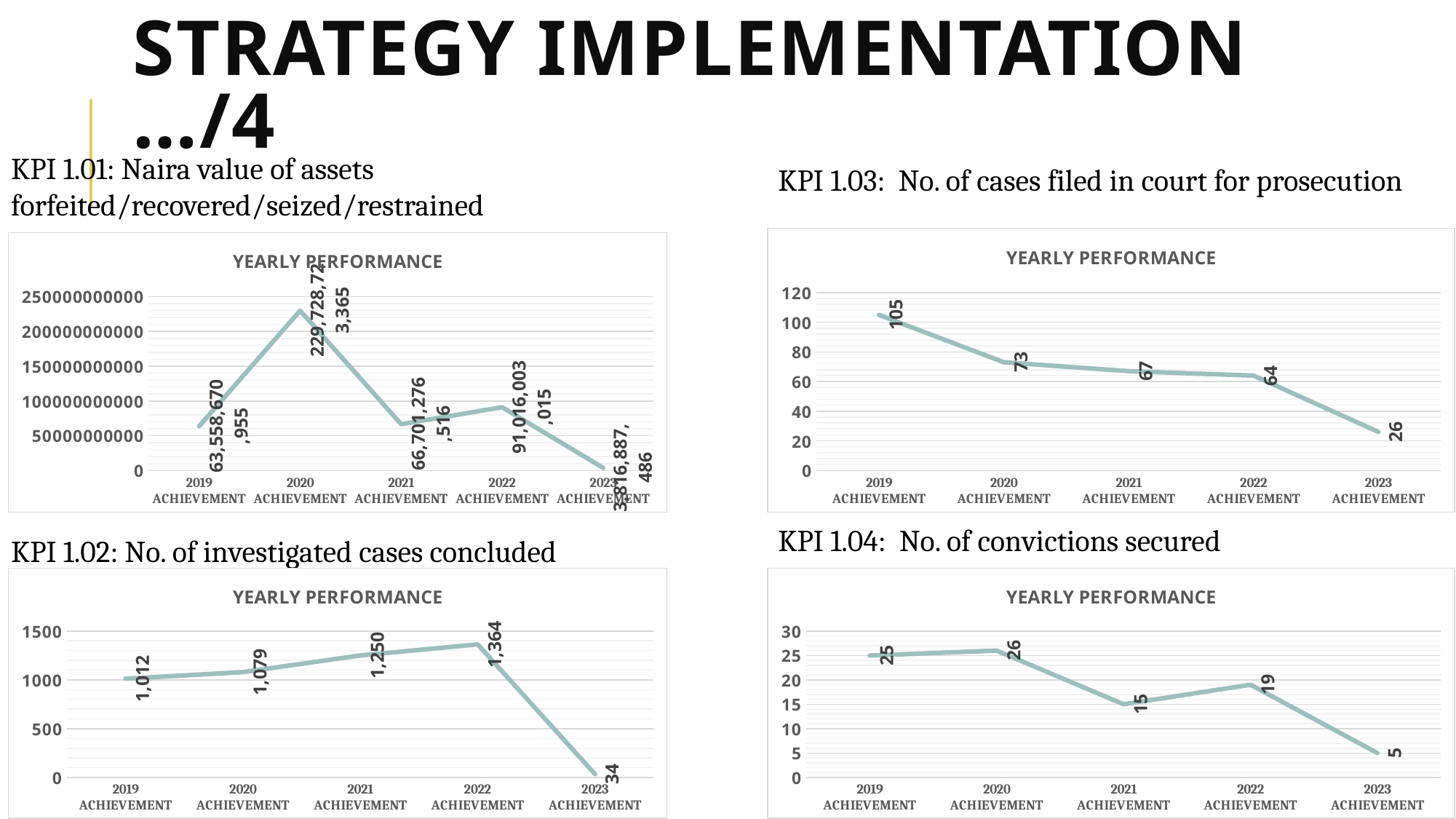
In the KPI 1.04 chart (No. of convictions secured), which is larger, the value for 2020 or the value for 2022? 2020 What type of chart is used for KPI 1.02 (No. of investigated cases concluded)? line chart In the KPI 1.03 chart (No. of cases filed in court for prosecution), what is the difference between the 2019 and 2023 values? 79 How many years are plotted in the KPI 1.04 chart (No. of convictions secured)? 5 In the KPI 1.03 chart (No. of cases filed in court for prosecution), what is the value for 2019 ACHIEVEMENT? 105 In the KPI 1.01 chart (Naira value of assets forfeited/recovered/seized/restrained), which year has the highest value? 2020 ACHIEVEMENT In the KPI 1.02 chart (No. of investigated cases concluded), what is the value for 2022 ACHIEVEMENT? 1,364 In the KPI 1.03 chart (No. of cases filed in court for prosecution), does the value fall or rise from 2019 to 2023? fall In the KPI 1.02 chart (No. of investigated cases concluded), which year has the lowest value? 2023 ACHIEVEMENT What is the title shown on the KPI 1.03 chart? YEARLY PERFORMANCE In the KPI 1.01 chart (Naira value of assets forfeited/recovered/seized/restrained), what is the value for 2019 ACHIEVEMENT? 63,558,670,955 In the KPI 1.04 chart (No. of convictions secured), what is the value for 2021 ACHIEVEMENT? 15